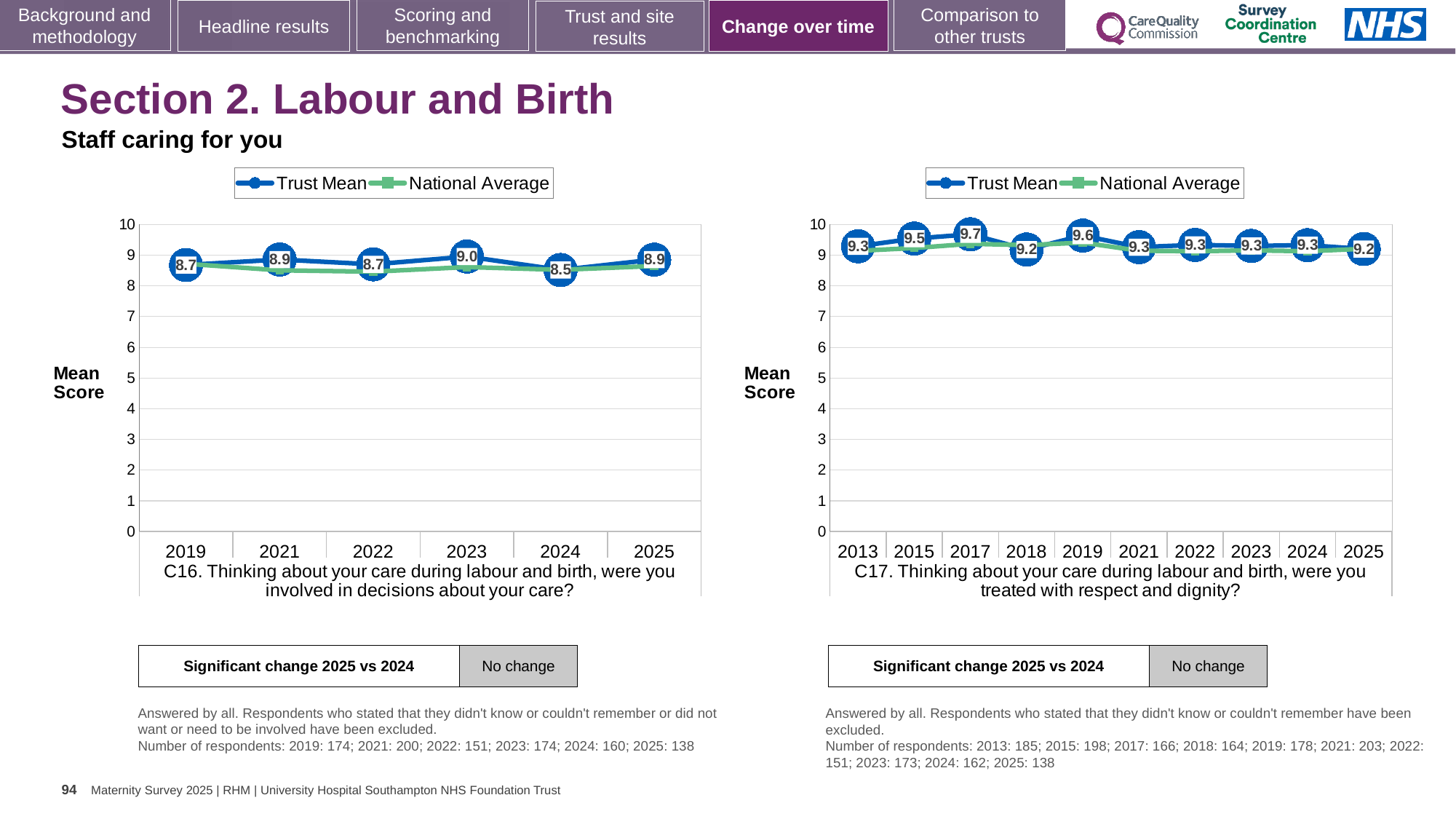
In the C16 chart on the left, what is the Trust Mean for 2023? 9.0 In the C16 chart on the left, how many years are shown on the x axis? 6 In the C17 chart on the right, which year has the highest Trust Mean? 2017 In the C16 chart on the left, what is the Trust Mean for 2024? 8.5 In the C17 chart on the right, how many years are shown on the x axis? 10 In the C17 chart on the right, is the Trust Mean for 2019 larger or smaller than for 2018? larger How many series does the legend of the C17 chart on the right list? 2 In the C16 chart on the left, which year has the highest Trust Mean? 2023 In the C16 chart on the left, what is the difference between the Trust Mean for 2025 and 2024? 0.4 In the C17 chart on the right, what is the Trust Mean for 2025? 9.2 In the C16 chart on the left, which year has the lowest Trust Mean? 2024 In the C17 chart on the right, what is the Trust Mean for 2017? 9.7